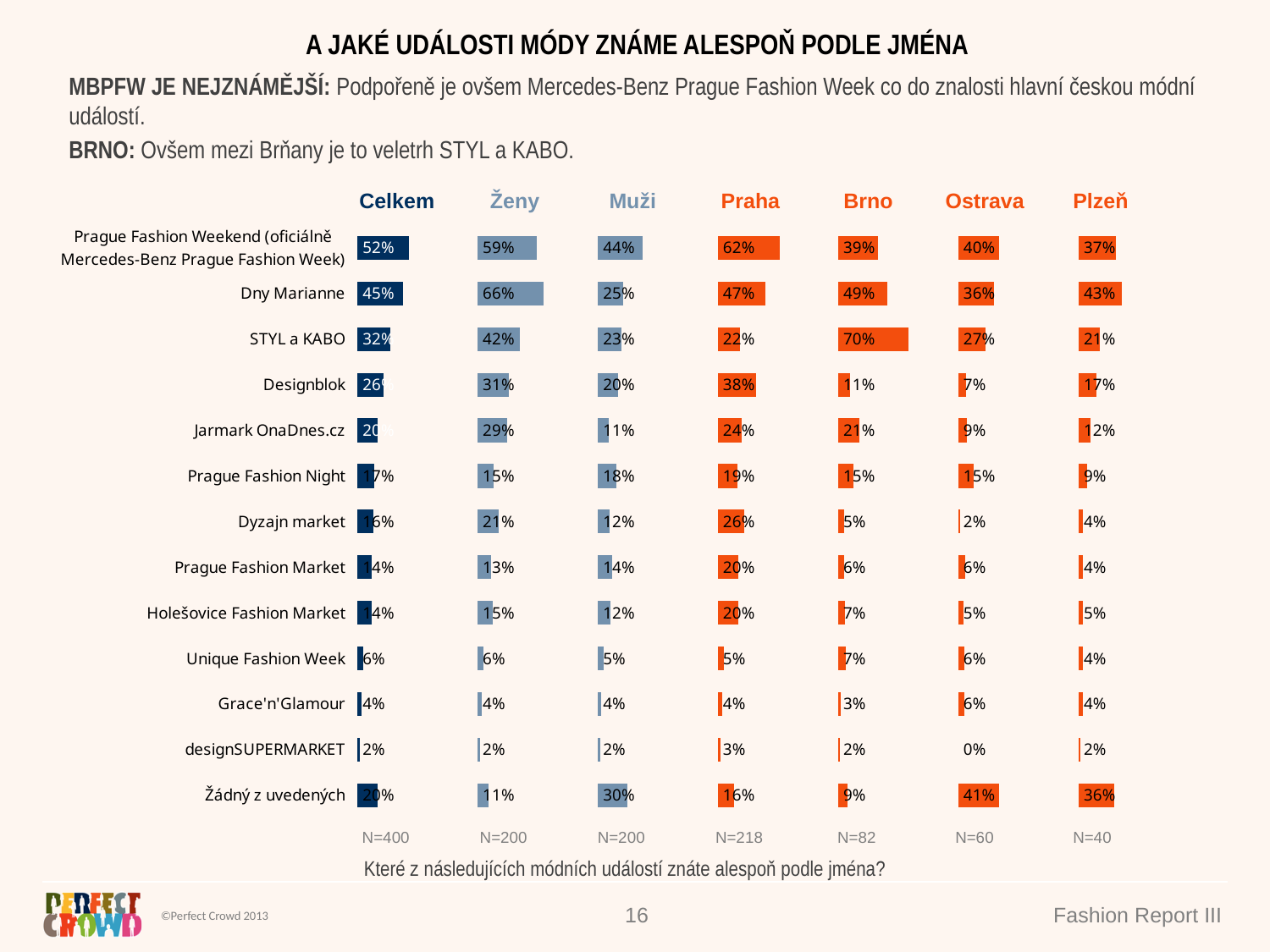
In the Brno chart, what is the value for Designblok? 11% In the Plzeň chart, which is larger: the value for Dny Marianne or the value for Žádný z uvedených? Dny Marianne In the Ostrava chart, which category has the highest value? Žádný z uvedených What kind of chart is used for each column on the slide? bar chart How many categories are listed in each chart on the slide? 13 In the Ostrava chart, what is the value for designSUPERMARKET? 0% What is the sample size (N) shown under the Praha chart? N=218 In the Muži chart, what is the difference between the values for Prague Fashion Weekend (44%) and Dny Marianne (25%)? 19% In the Brno chart, what is the value for STYL a KABO? 70% In the Praha chart, what is the value for Prague Fashion Weekend (oficiálně Mercedes-Benz Prague Fashion Week)? 62% In the Ženy chart, what is the value for Dny Marianne? 66% In the Celkem chart, which category has the lowest value? designSUPERMARKET